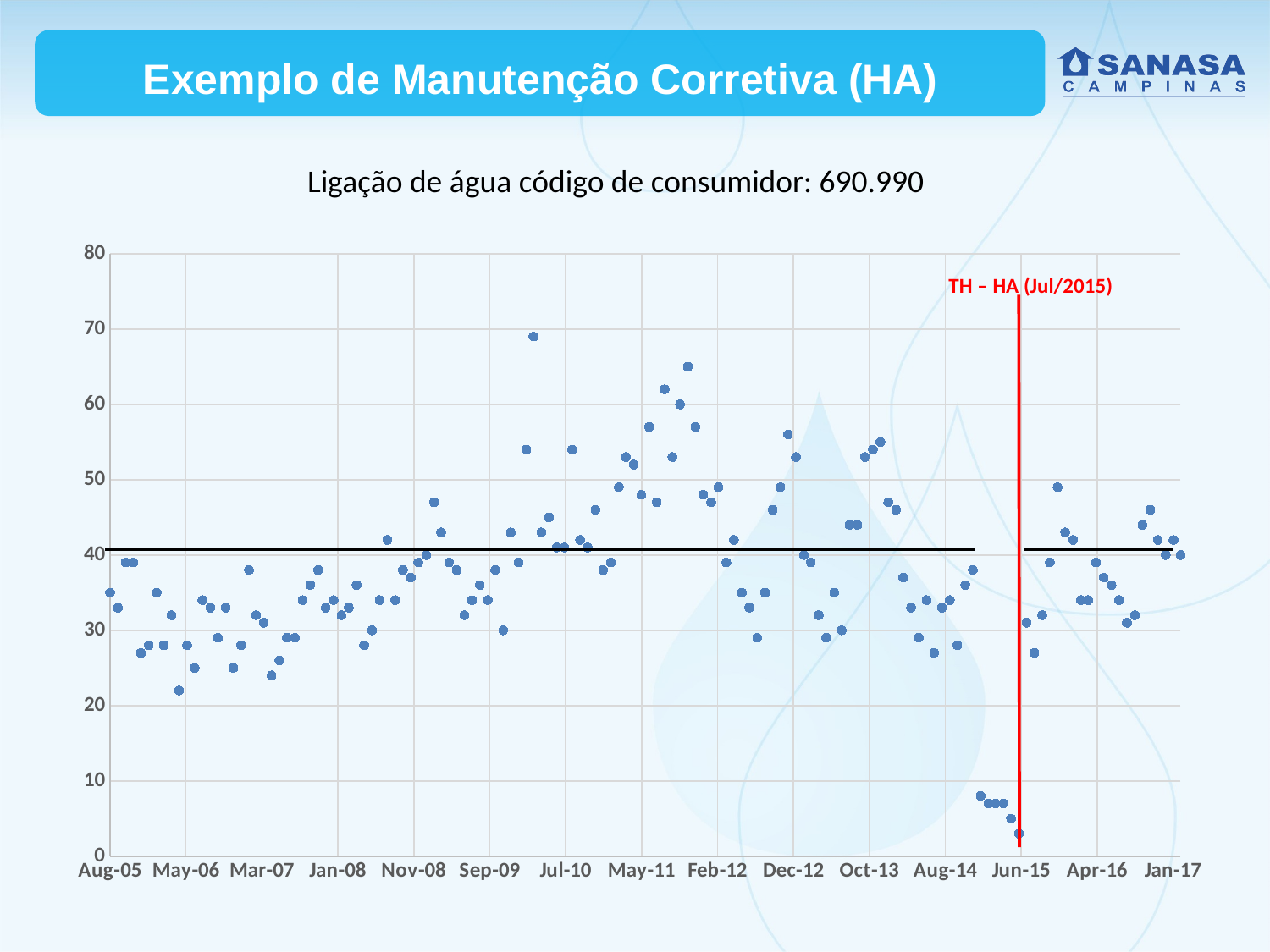
Is the value plotted at Aug-05 greater or less than 40? less Is the value plotted at Jun-15 greater or less than 10? less How many date labels are shown along the horizontal axis of the chart? 15 What kind of chart is shown on the slide? scatter chart Is the highest point plotted on the chart greater or less than 60? greater Which is larger, the value plotted at Jun-15 or the value plotted at Jan-17? Jan-17 What label is written next to the red vertical line on the chart? TH – HA (Jul/2015) What is the highest value shown on the vertical axis of the chart? 80